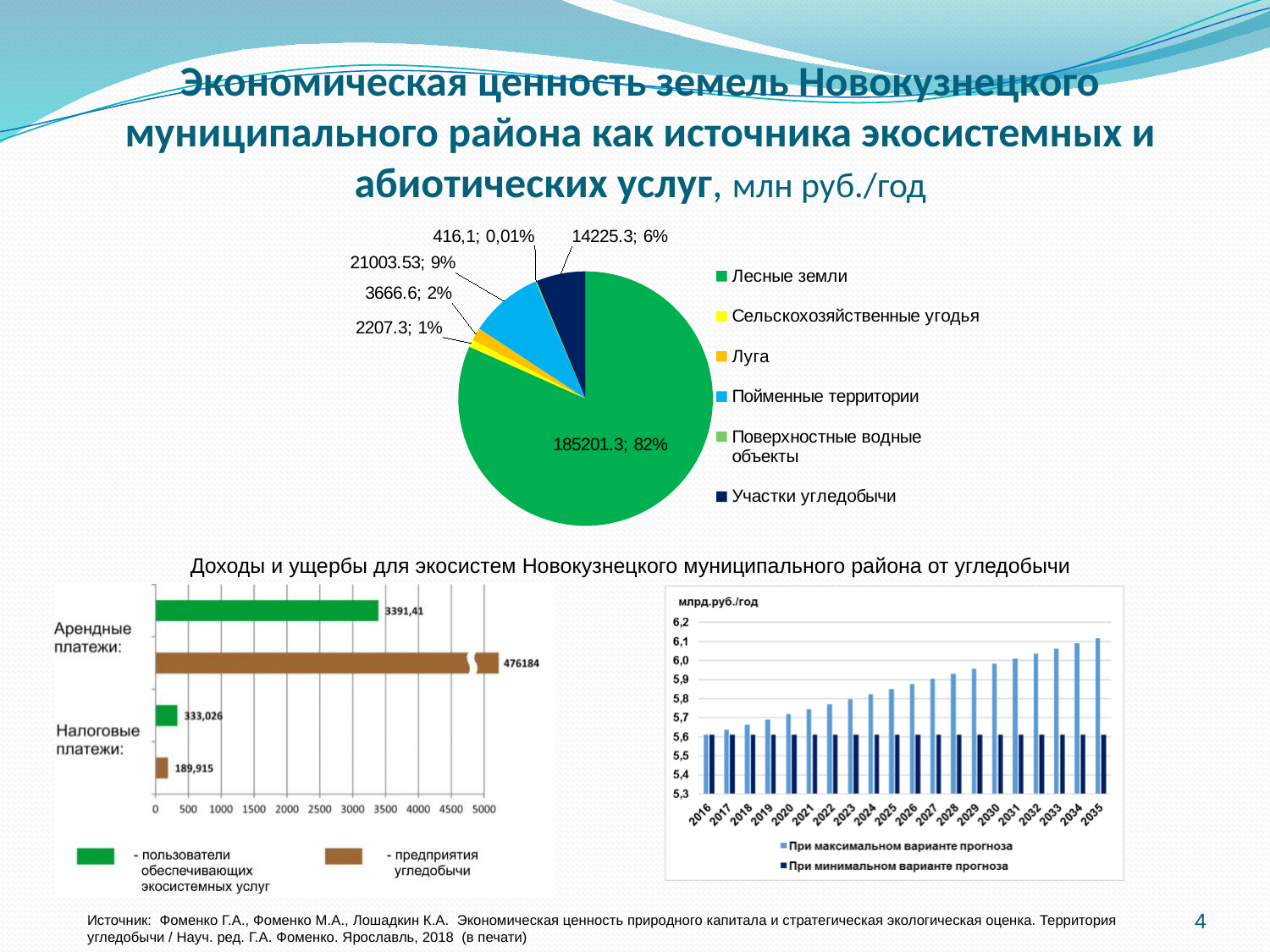
In the pie chart, what share of the total do Участки угледобычи account for? 6% In the pie chart, which category has the smallest slice? Поверхностные водные объекты What type of chart is the bottom-left chart showing Арендные платежи and Налоговые платежи? bar chart In the bottom-left bar chart, what is the value of Налоговые платежи for пользователи обеспечивающих экосистемных услуг? 333,026 In the bottom-right chart, how many years are shown on the x axis? 20 In the pie chart, what value is shown for Пойменные территории? 21003.53 In the bottom-left bar chart, what is the value of Арендные платежи for предприятия угледобычи? 476184 In the pie chart, what value and share are shown for Лесные земли? 185201.3; 82% In the bottom-right chart, do the values for При максимальном варианте прогноза rise or fall from 2016 to 2035? rise How many categories does the legend of the pie chart list? 6 In the pie chart, which is larger: the value for Луга or the value for Сельскохозяйственные угодья? Луга In the pie chart, which category has the largest slice? Лесные земли